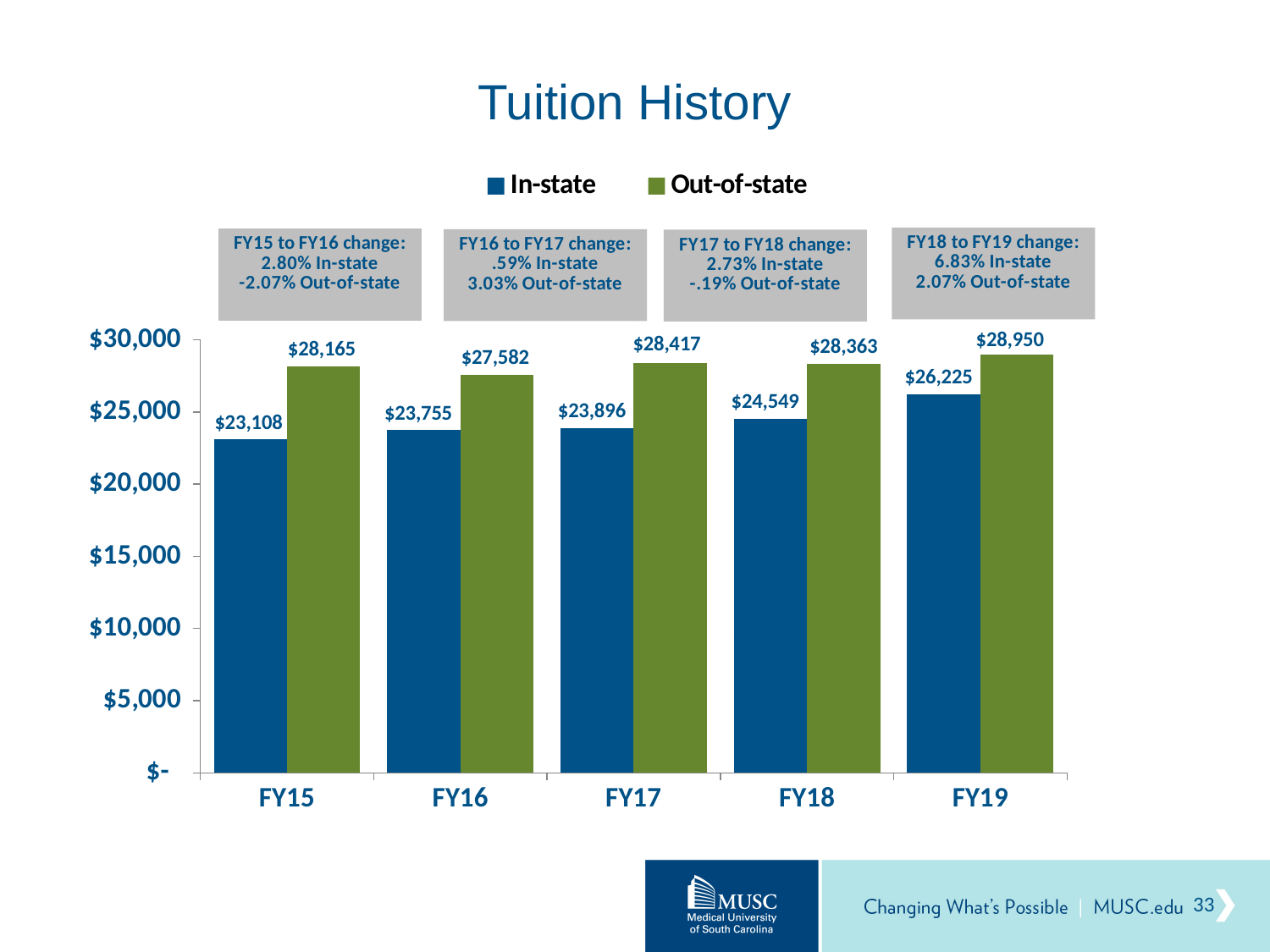
Which is larger, the Out-of-state tuition in FY17 or in FY18? FY17 Which fiscal year has the highest In-state tuition? FY19 What is the difference between Out-of-state and In-state tuition in FY15? $5,057 How many series does the legend list? 2 What is the In-state tuition for FY17? $23,896 Does In-state tuition rise or fall from FY15 to FY19? Rise What is the Out-of-state tuition for FY16? $27,582 Which fiscal year has the lowest Out-of-state tuition? FY16 What kind of chart is shown on the slide? Bar chart What is the Out-of-state tuition for FY19? $28,950 By how much did In-state tuition increase from FY18 to FY19? $1,676 How many fiscal years are shown on the x axis? 5